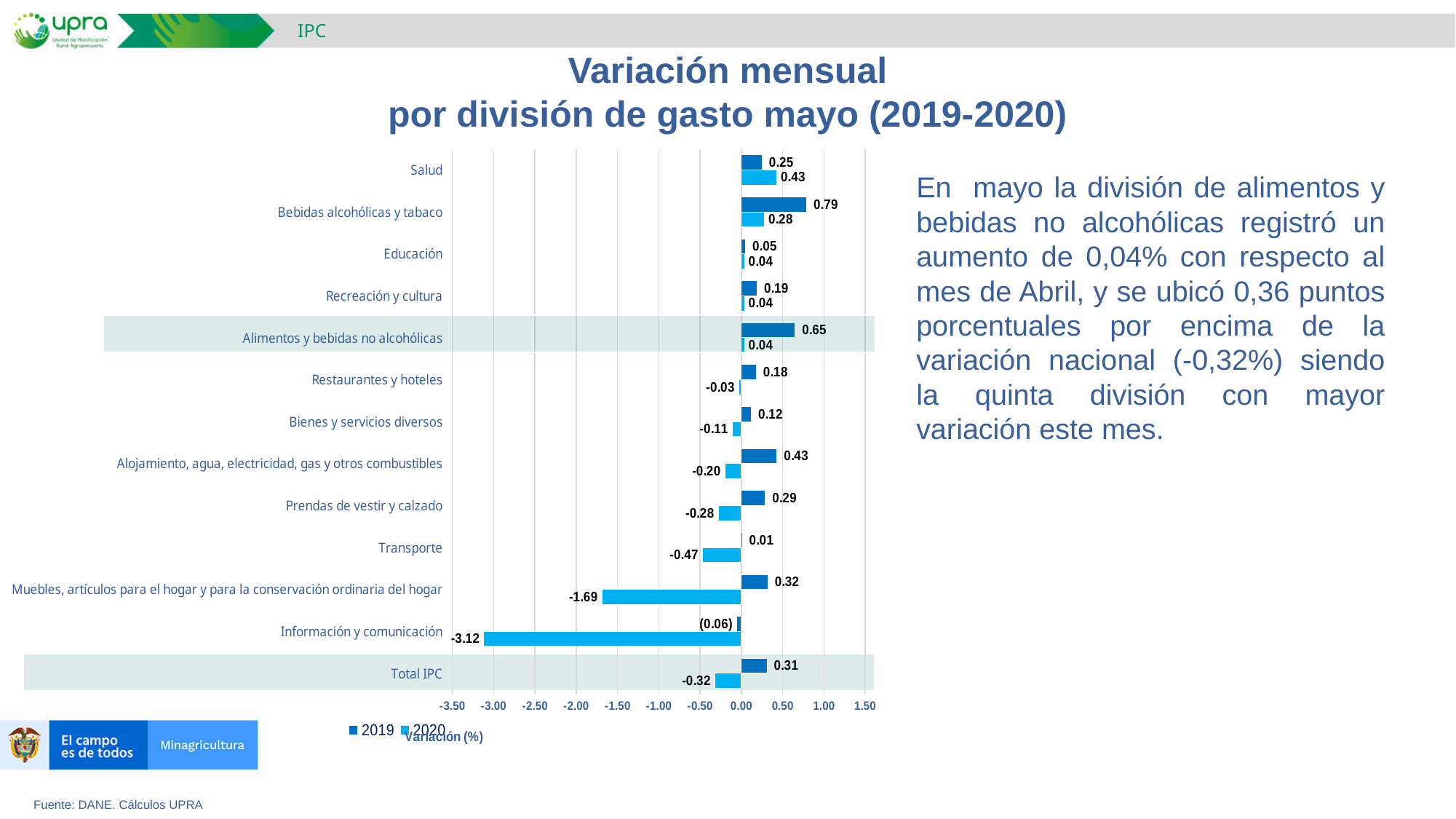
How many series does the legend list? 2 What is the difference between the 2019 and 2020 values for Alimentos y bebidas no alcohólicas? 0.61 How many categories are shown on the chart? 13 What is the 2019 value for Bebidas alcohólicas y tabaco? 0.79 Which is larger for Salud, the 2019 value or the 2020 value? 2020 Which category has the highest 2019 value? Bebidas alcohólicas y tabaco What is the label of the x axis? Variación (%) What is the 2020 value for Total IPC? -0.32 What is the 2020 value for Salud? 0.43 Which category has the lowest 2020 value? Información y comunicación What type of chart is shown on the slide? bar chart What is the 2020 value for Información y comunicación? -3.12